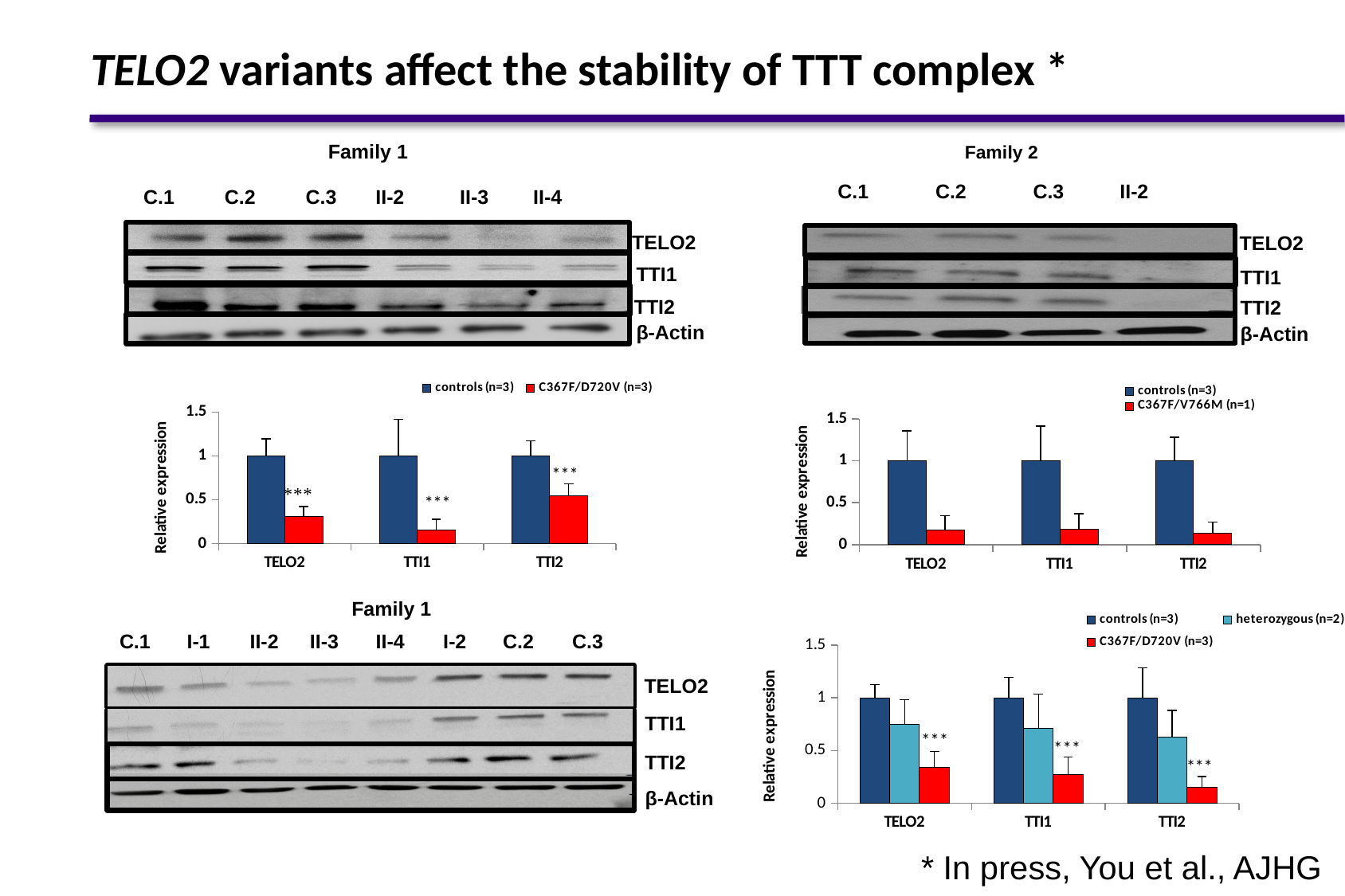
In the top-left bar chart (Family 1), what is the relative expression of controls (n=3) for TELO2? 1 What kind of chart is the top-right chart (Family 2)? bar chart In the bottom-right bar chart, which series has the lowest value for TTI2? C367F/D720V (n=3) In the top-right bar chart (Family 2), is the value for C367F/V766M (n=1) at TELO2 greater or less than 0.5? less In the bottom-right bar chart, which is larger for TTI1: controls (n=3) or heterozygous (n=2)? controls (n=3) In the bottom-right bar chart, is the value for heterozygous (n=2) at TELO2 greater or less than 0.5? greater In the top-left bar chart (Family 1), is the value for C367F/D720V (n=3) at TTI2 greater or less than 0.5? greater In the bottom-right bar chart, how many series does the legend list? 3 In the top-left bar chart (Family 1), how many categories are shown on the x axis? 3 What is the y-axis label of the top-right bar chart (Family 2)? Relative expression In the top-left bar chart (Family 1), how many series does the legend list? 2